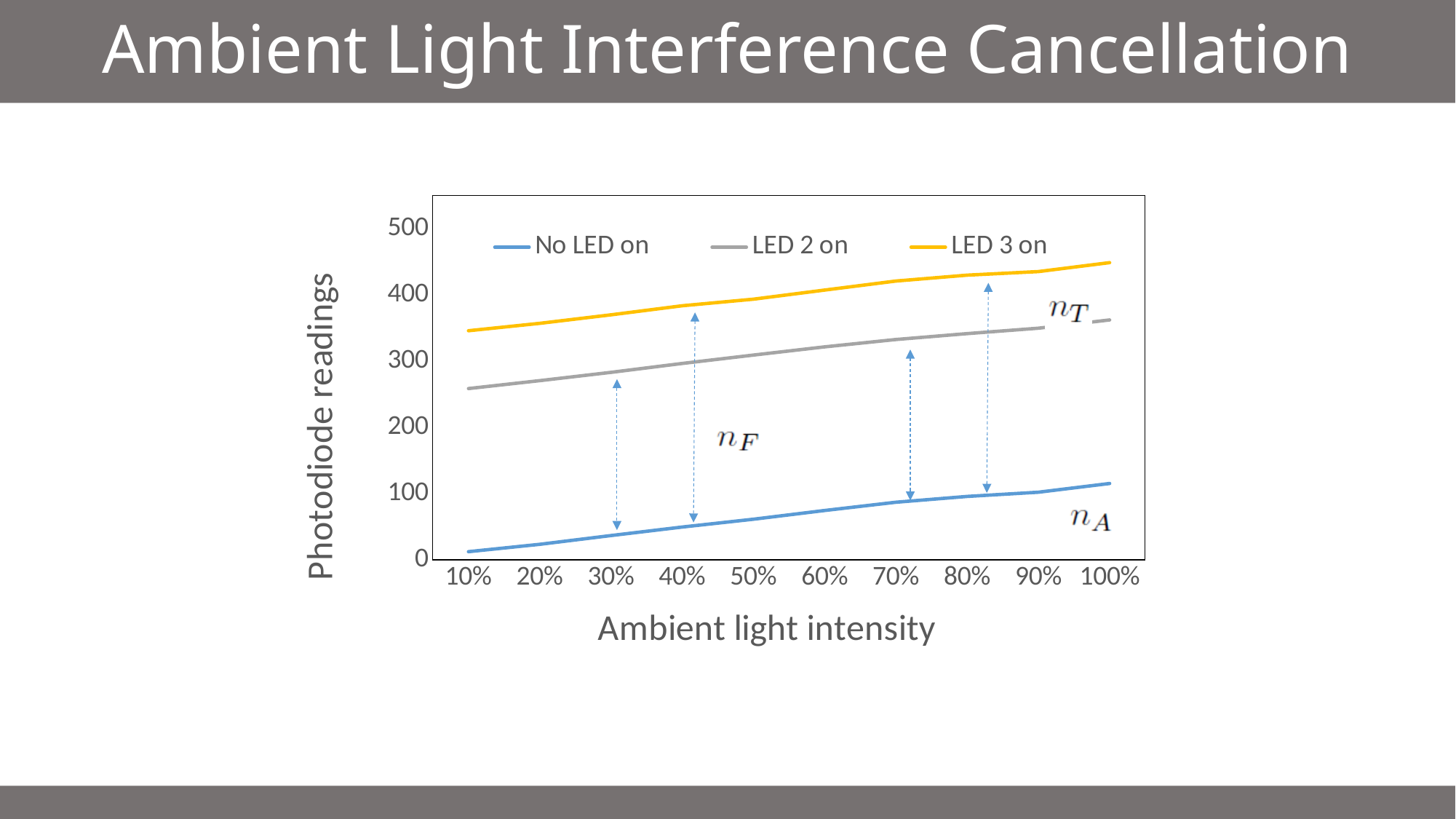
Is the 'LED 2 on' reading at 10% ambient light intensity greater or less than 300? less Which series has the lowest photodiode readings across all ambient light intensities? No LED on At 50% ambient light intensity, which series has the larger photodiode reading, 'LED 2 on' or 'No LED on'? LED 2 on How many ambient light intensity levels are plotted along the x axis? 10 Is the 'LED 3 on' reading at 100% ambient light intensity greater or less than 400? greater Which series has the highest photodiode readings across all ambient light intensities? LED 3 on What is the label of the x axis? Ambient light intensity What kind of chart is shown on the slide? line chart Do the photodiode readings for the 'No LED on' series rise or fall as ambient light intensity increases? rise Is the 'No LED on' reading at 10% ambient light intensity greater or less than 100? less How many series does the legend list? 3 Do the photodiode readings for the 'LED 3 on' series rise or fall as ambient light intensity increases? rise